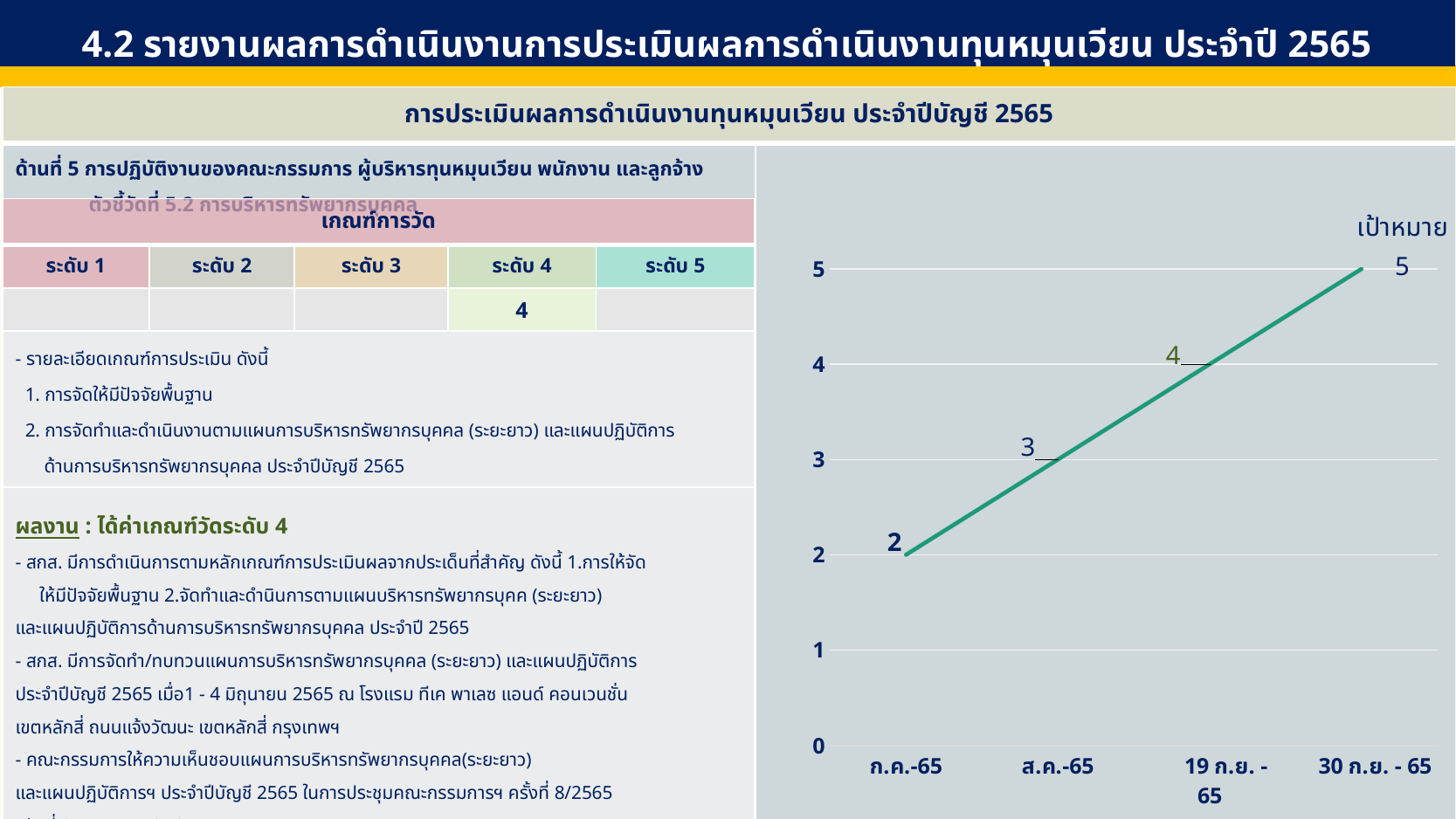
Do the values on the line chart rise or fall from left to right along the x axis? rise Which category has the highest value on the line chart? 30 ก.ย. - 65 What is the value plotted for ก.ค.-65? 2 What is the difference between the values for 30 ก.ย. - 65 and ก.ค.-65? 3 What is the value plotted for ส.ค.-65? 3 What is the value plotted for 19 ก.ย. - 65? 4 What kind of chart is shown on the right side of the slide? line chart Which is larger, the value for ส.ค.-65 or the value for 19 ก.ย. - 65? 19 ก.ย. - 65 What label appears above the right end of the line on the chart? เป้าหมาย What is the value plotted for 30 ก.ย. - 65? 5 Which category has the lowest value on the line chart? ก.ค.-65 How many categories are shown on the x axis of the line chart? 4